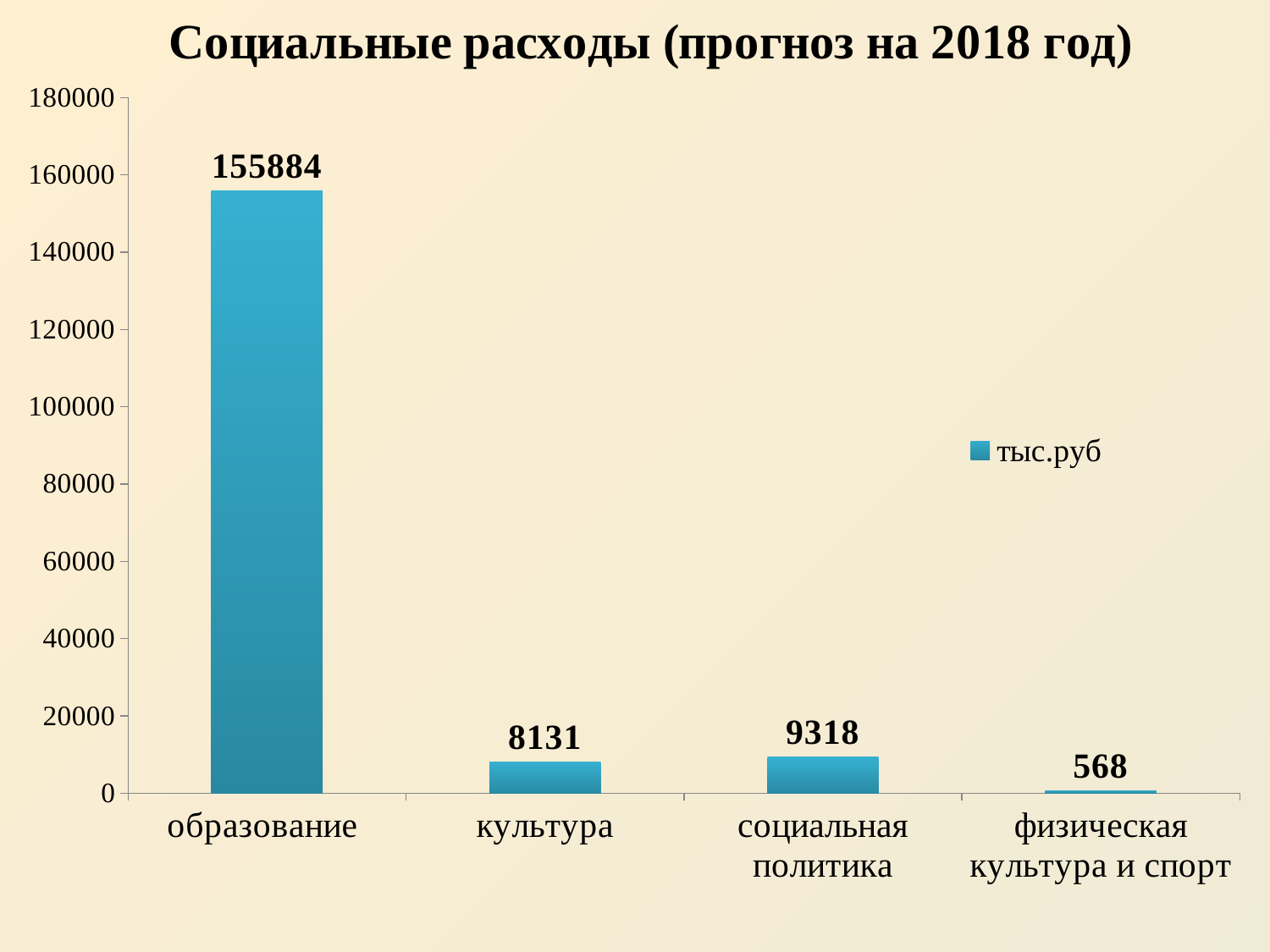
What is the value for культура? 8131 What kind of chart is shown on the slide? bar chart Is the value for образование greater or less than 140000? greater What is the value for образование? 155884 What is the value for социальная политика? 9318 Which is larger, the value for культура or the value for социальная политика? социальная политика Which category has the highest value? образование What is the title of the chart? Социальные расходы (прогноз на 2018 год) Which category has the lowest value? физическая культура и спорт What is the difference between the values for социальная политика and культура? 1187 How many categories are shown on the x axis? 4 What is the value for физическая культура и спорт? 568